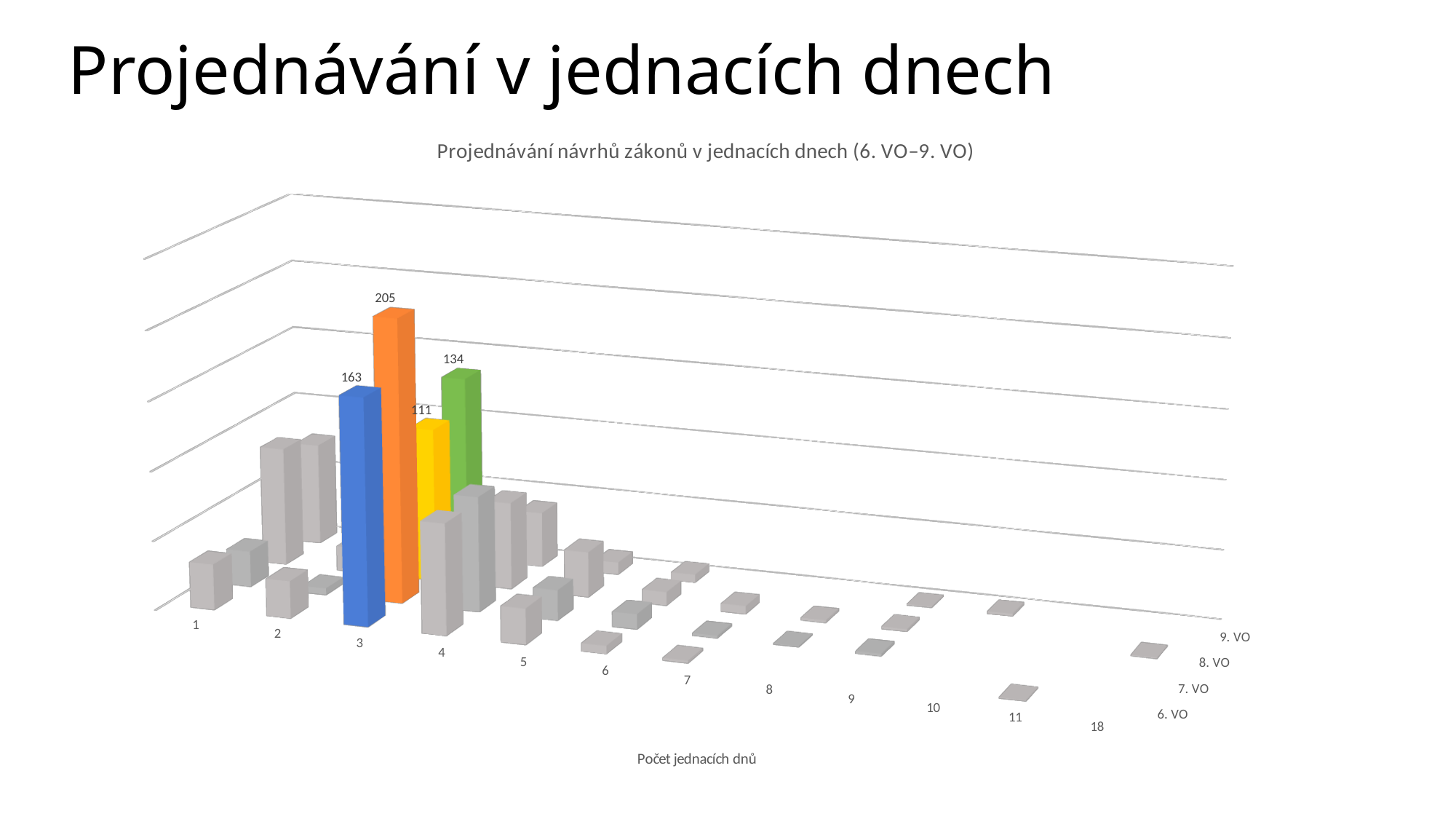
What is the value for 8. VO at category 3? 111 At category 3, which is larger: the value for 9. VO or for 8. VO? 9. VO What kind of chart is shown on the slide? Bar chart Which series has the highest value at category 3? 7. VO What is the value for 9. VO at category 3? 134 What is the difference between the 7. VO and 6. VO values at category 3? 42 What is the value for 7. VO at 3 jednací dny (category 3)? 205 Which series has the lowest value at category 3? 8. VO What is the title of the chart? Projednávání návrhů zákonů v jednacích dnech (6. VO–9. VO) What is the value for 6. VO at category 3? 163 How many categories are shown on the x axis (Počet jednacích dnů)? 12 How many series (VO) does the chart show? 4